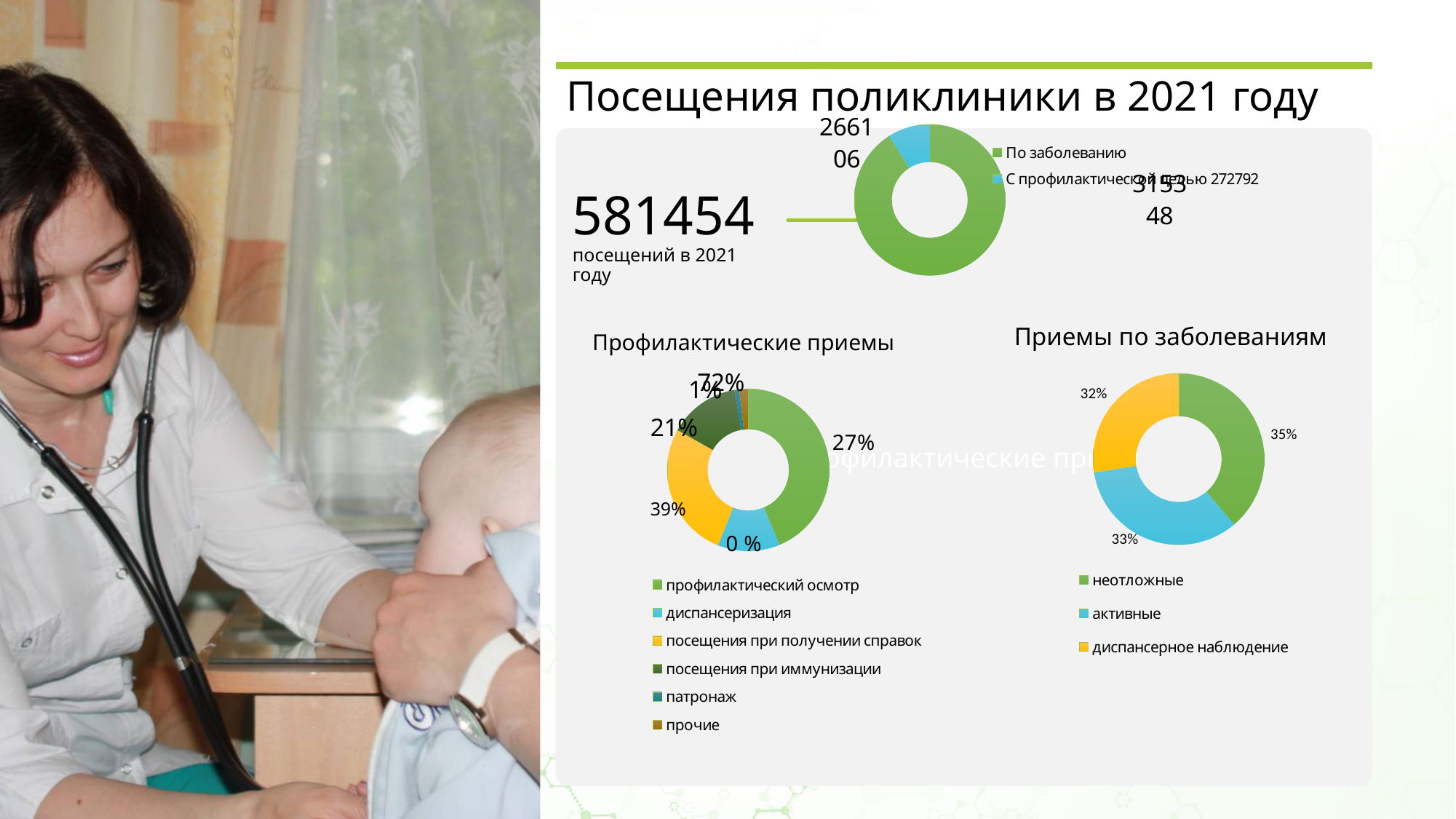
How many categories does the legend of the "Профилактические приемы" chart list? 6 In the "Приемы по заболеваниям" chart, what is the share for неотложные? 35% In the "Приемы по заболеваниям" chart, which category has the largest share? неотложные What kind of chart is "Приемы по заболеваниям"? Pie (donut) chart In the "Приемы по заболеваниям" chart, what is the difference in percentage points between неотложные and диспансерное наблюдение? 3 percentage points How many categories does the legend of the top donut chart next to "581454" list? 2 In the "Приемы по заболеваниям" chart, what is the share for диспансерное наблюдение? 32% In the "Профилактические приемы" chart, what is the share for профилактический осмотр? 27% How many categories does the legend of the "Приемы по заболеваниям" chart list? 3 In the "Профилактические приемы" chart, what is the share for посещения при получении справок? 39% In the "Приемы по заболеваниям" chart, what is the share for активные? 33%